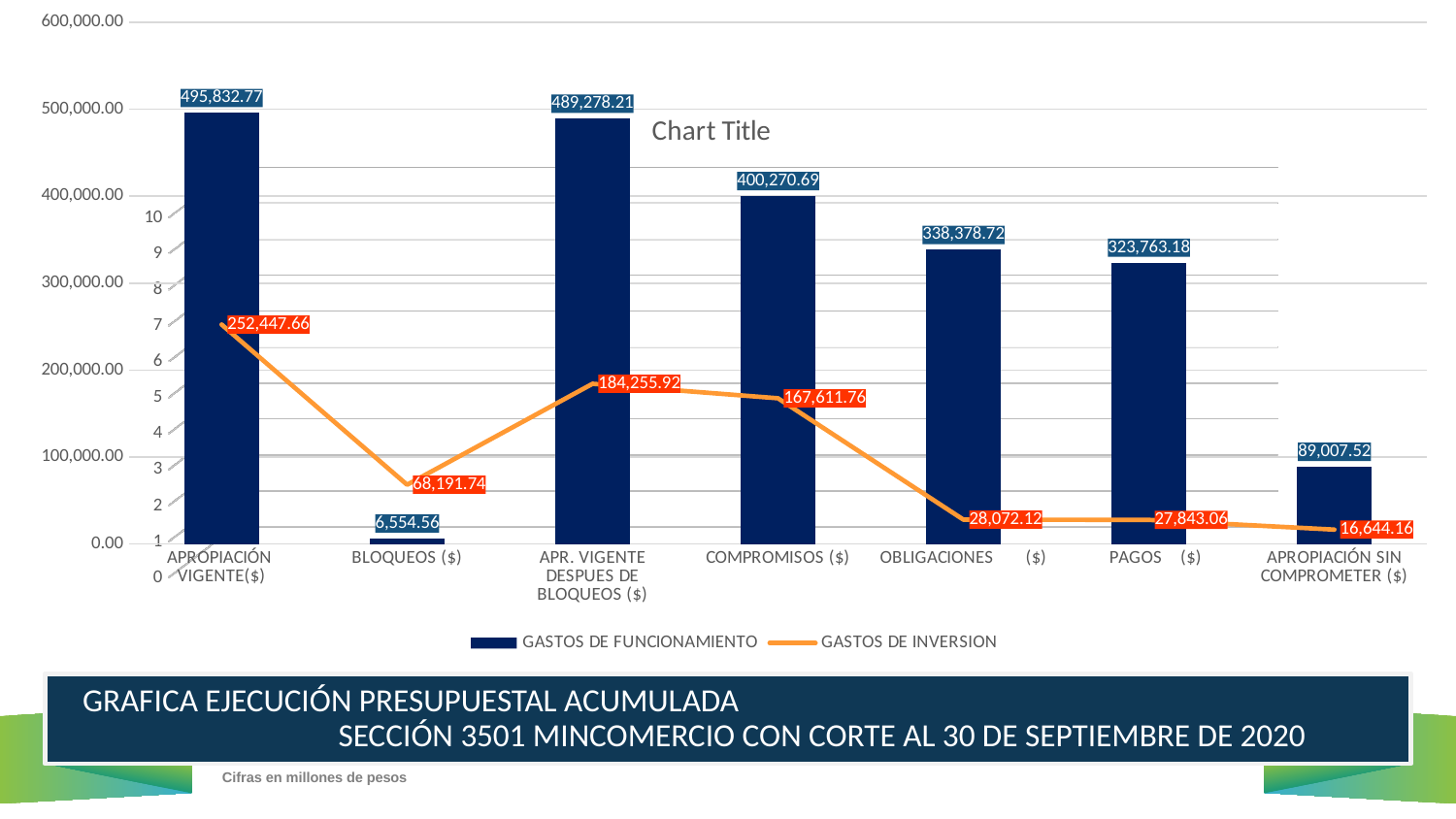
Which category has the lowest GASTOS DE FUNCIONAMIENTO value? BLOQUEOS ($) What is the difference between the GASTOS DE INVERSION values for APROPIACIÓN VIGENTE($) and APR. VIGENTE DESPUES DE BLOQUEOS ($)? 68,191.74 Which category has the highest GASTOS DE INVERSION value? APROPIACIÓN VIGENTE($) How many categories are shown on the x axis? 7 Which series is drawn as a line rather than bars? GASTOS DE INVERSION What is the GASTOS DE FUNCIONAMIENTO value for APROPIACIÓN VIGENTE($)? 495,832.77 What is the GASTOS DE INVERSION value for COMPROMISOS ($)? 167,611.76 Which is larger for OBLIGACIONES ($): GASTOS DE FUNCIONAMIENTO or GASTOS DE INVERSION? GASTOS DE FUNCIONAMIENTO What is the GASTOS DE INVERSION value for APROPIACIÓN SIN COMPROMETER ($)? 16,644.16 What is the difference between the GASTOS DE FUNCIONAMIENTO values for APROPIACIÓN VIGENTE($) and APR. VIGENTE DESPUES DE BLOQUEOS ($)? 6,554.56 What is the GASTOS DE FUNCIONAMIENTO value for PAGOS ($)? 323,763.18 How many series does the legend list? 2